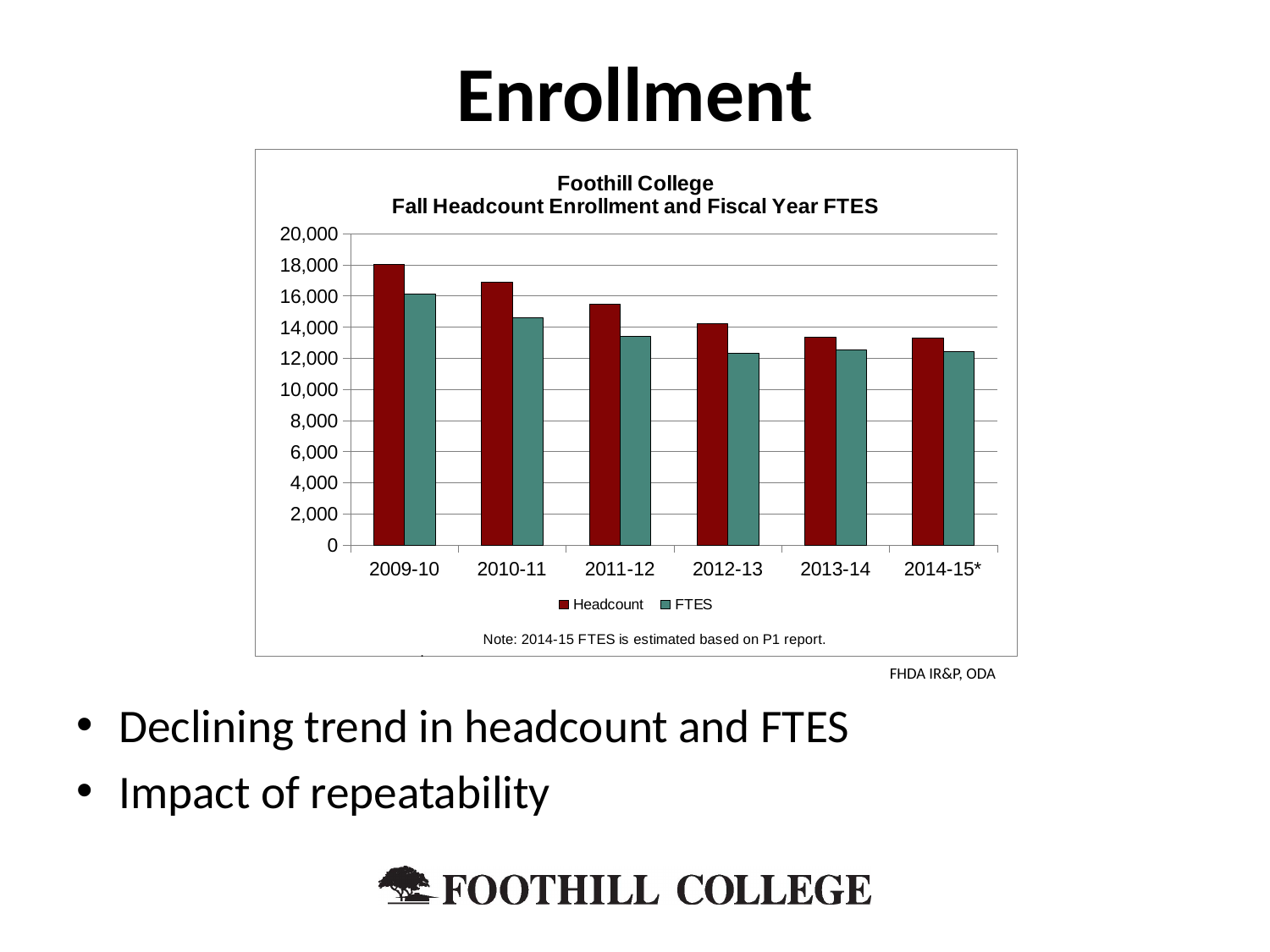
What kind of chart is shown on the slide? Bar chart Is the Headcount for 2011-12 greater or less than 14,000? greater Does Headcount rise or fall from 2009-10 to 2014-15*? Fall Is the Headcount for 2013-14 greater or less than 14,000? less In 2010-11, which is larger, Headcount or FTES? Headcount Which year has the highest Headcount? 2009-10 Which year has the highest FTES? 2009-10 According to the note below the legend, what is the 2014-15 FTES estimate based on? P1 report How many academic years are shown on the x axis? 6 How many series does the legend list? 2 Is the Headcount for 2009-10 greater or less than 16,000? greater